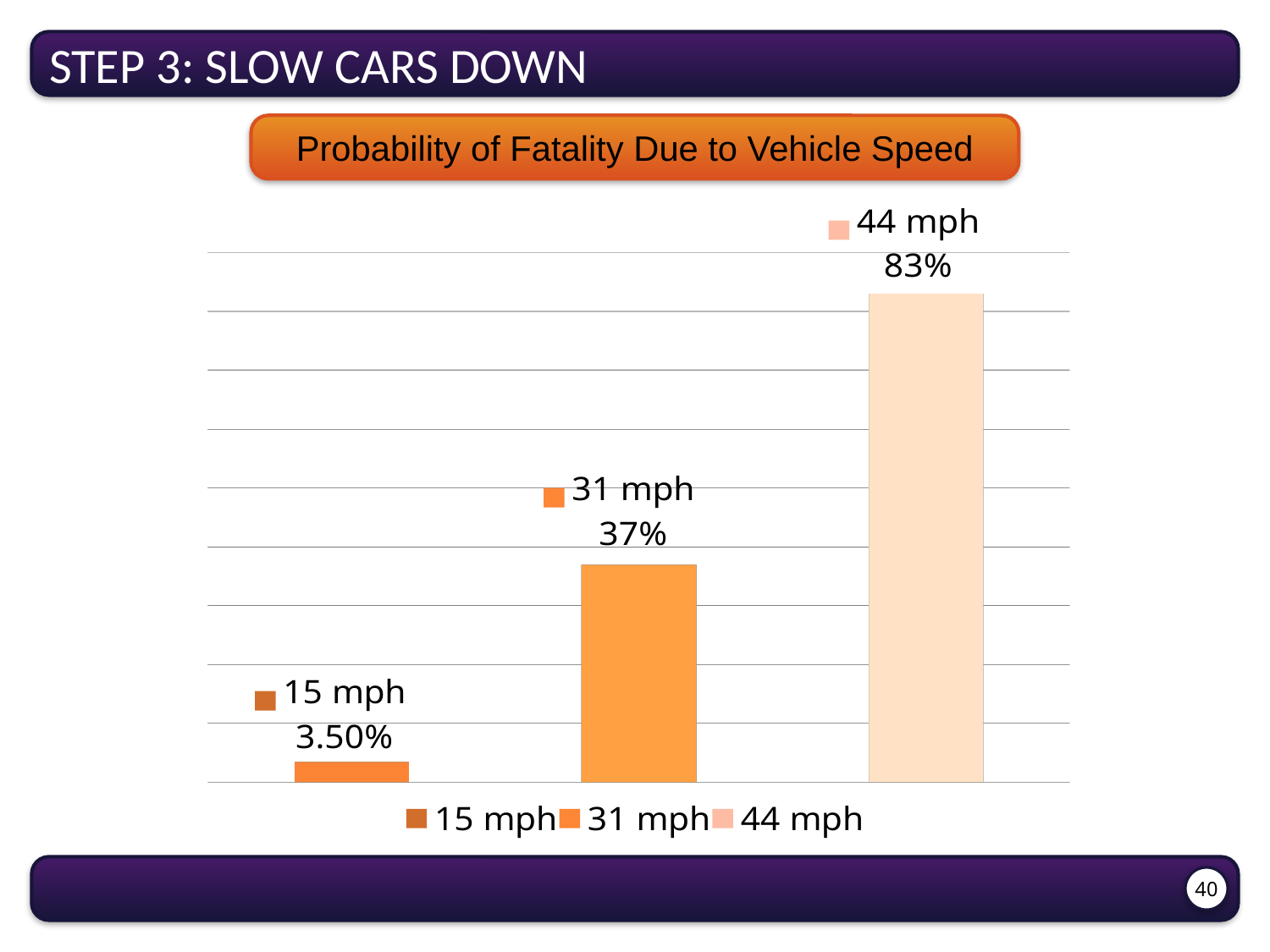
What kind of chart is shown on the slide? Bar chart How many speed categories are shown in the chart? 3 How many entries does the legend list? 3 Which speed has the highest probability of fatality? 44 mph What is the probability of fatality at 31 mph? 37% Which has a higher probability of fatality, 31 mph or 44 mph? 44 mph What is the difference between the probability of fatality at 31 mph and at 15 mph? 33.50% Which speed has the lowest probability of fatality? 15 mph What is the title of the chart? Probability of Fatality Due to Vehicle Speed What is the probability of fatality at 15 mph? 3.50% What is the probability of fatality at 44 mph? 83% What is the difference between the probability of fatality at 44 mph and at 31 mph? 46%